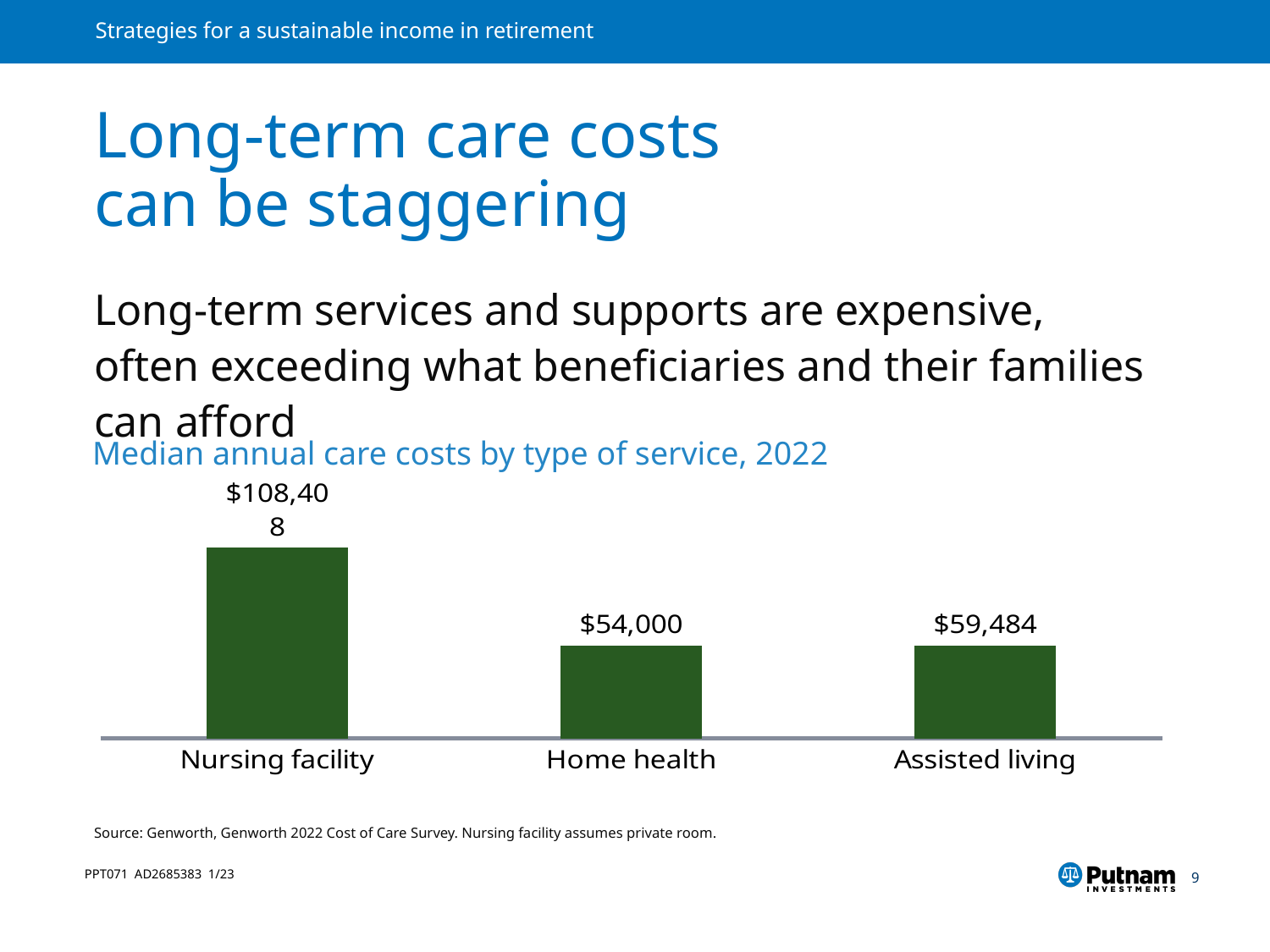
What is the median annual cost for home health? $54,000 Which type of service has the lowest median annual cost? Home health How many types of service are shown in the chart? 3 What is the title of the chart? Median annual care costs by type of service, 2022 What is the median annual cost for assisted living? $59,484 What is the difference between the nursing facility and assisted living median annual costs? $48,924 Which costs more per year, assisted living or home health? Assisted living Which type of service has the highest median annual cost? Nursing facility What kind of chart is used to show the median annual care costs? Bar chart How much more does a nursing facility cost per year than home health? $54,408 What is the median annual cost for a nursing facility? $108,408 What is the difference between the assisted living and home health median annual costs? $5,484